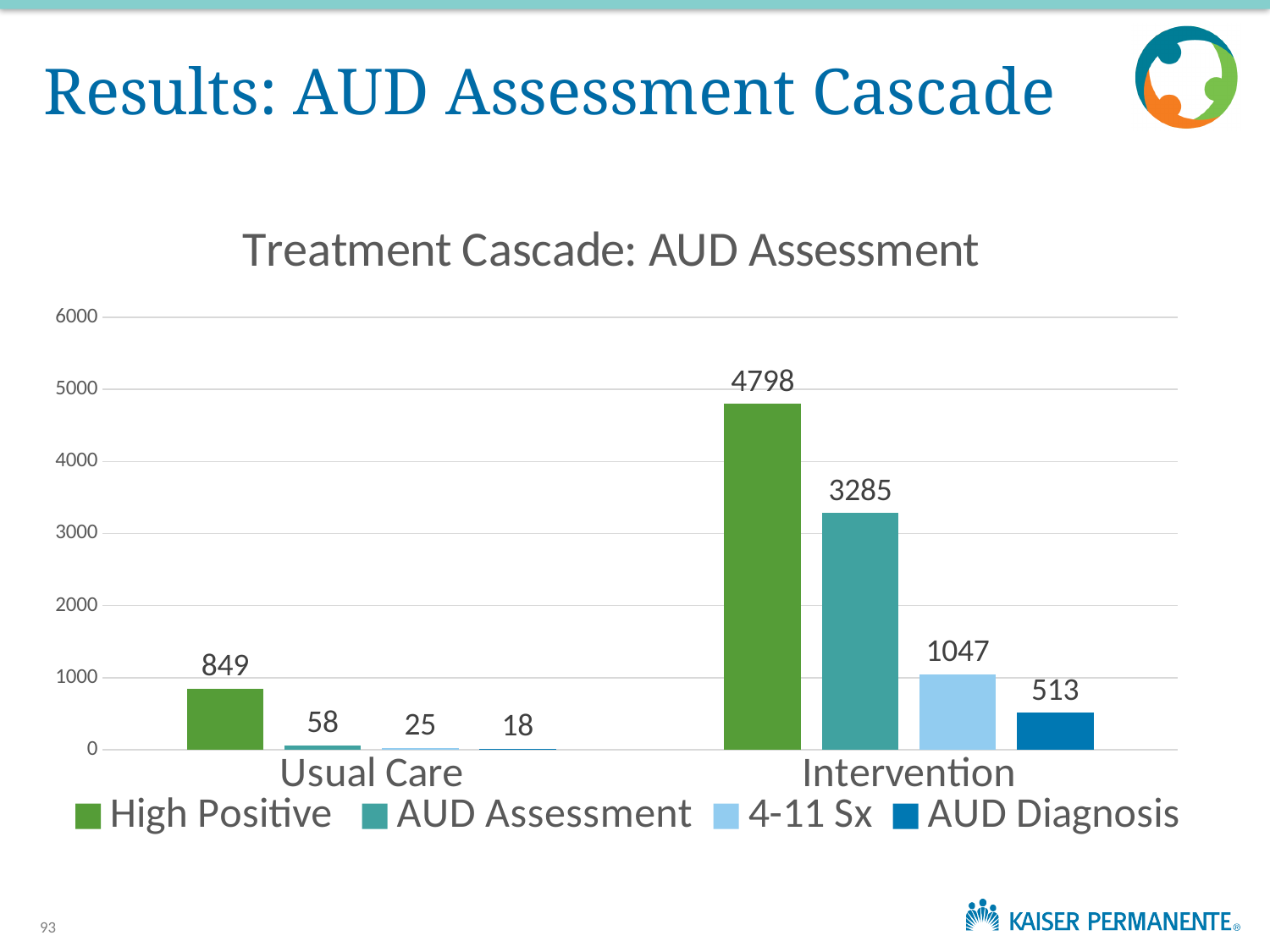
What is the value for AUD Diagnosis in the Usual Care group? 18 What is the value for AUD Assessment in the Usual Care group? 58 Which series has the highest value in the Intervention group? High Positive What is the difference between High Positive and AUD Assessment in the Intervention group? 1513 Which is larger: AUD Diagnosis in the Intervention group or High Positive in the Usual Care group? High Positive in the Usual Care group What is the title of the chart? Treatment Cascade: AUD Assessment What is the value for High Positive in the Intervention group? 4798 How many categories are shown on the x axis? 2 What kind of chart is shown on the slide? Bar chart How many series does the legend list? 4 What is the value for 4-11 Sx in the Intervention group? 1047 Which series has the lowest value in the Usual Care group? AUD Diagnosis